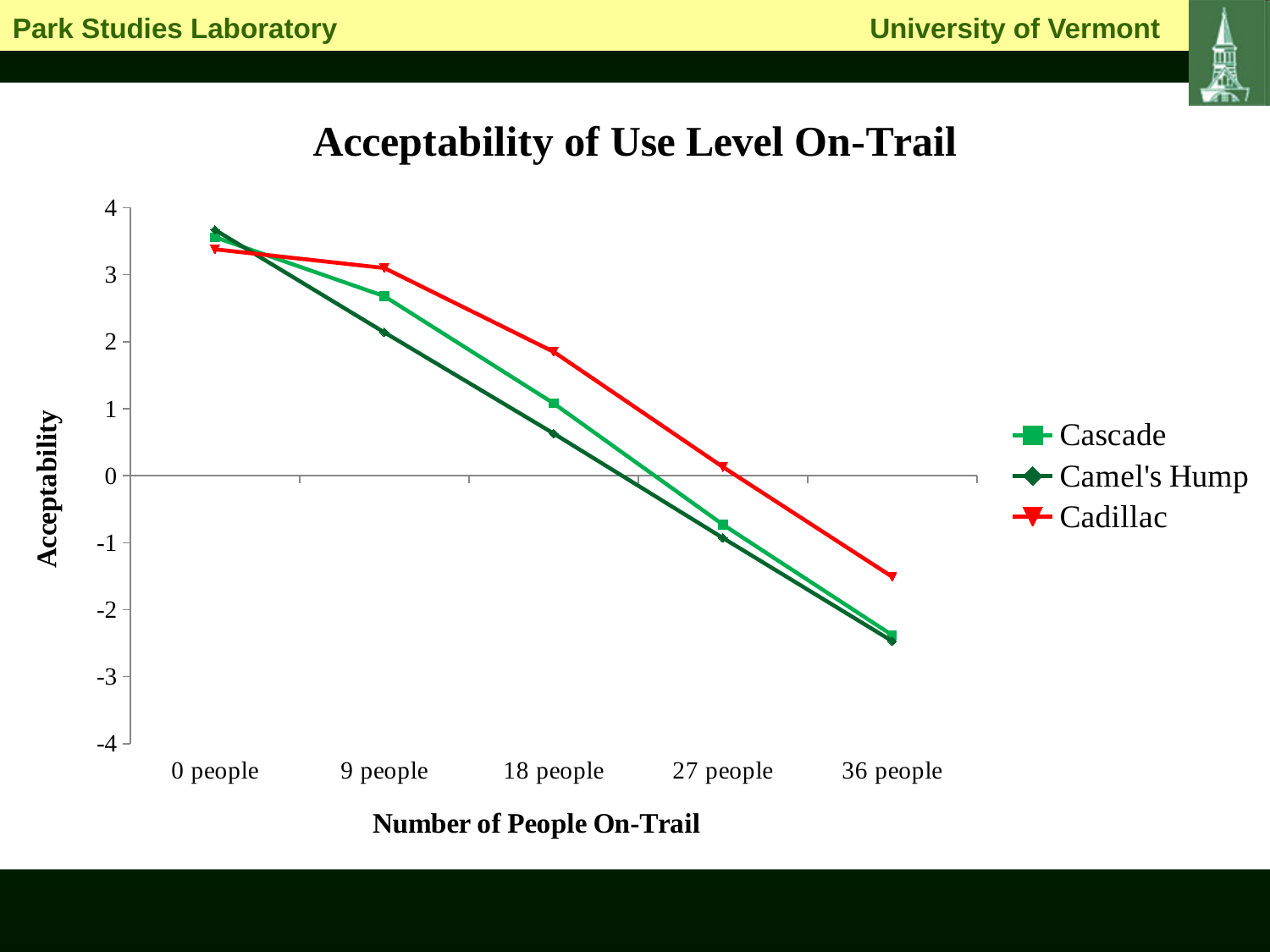
Is the value for Cadillac at 36 people greater or less than -1? less Is the value for Cadillac at 18 people greater or less than 1? greater How many use-level categories are shown on the x axis? 5 How many series does the legend list? 3 What kind of chart is shown on the slide? line chart Do the acceptability values rise or fall as the number of people on-trail increases? fall At 18 people, which is larger: the value for Cadillac or the value for Camel's Hump? Cadillac Which series has the highest acceptability at 27 people? Cadillac Is the value for Cascade at 9 people greater or less than 3? less What is the title of the chart? Acceptability of Use Level On-Trail